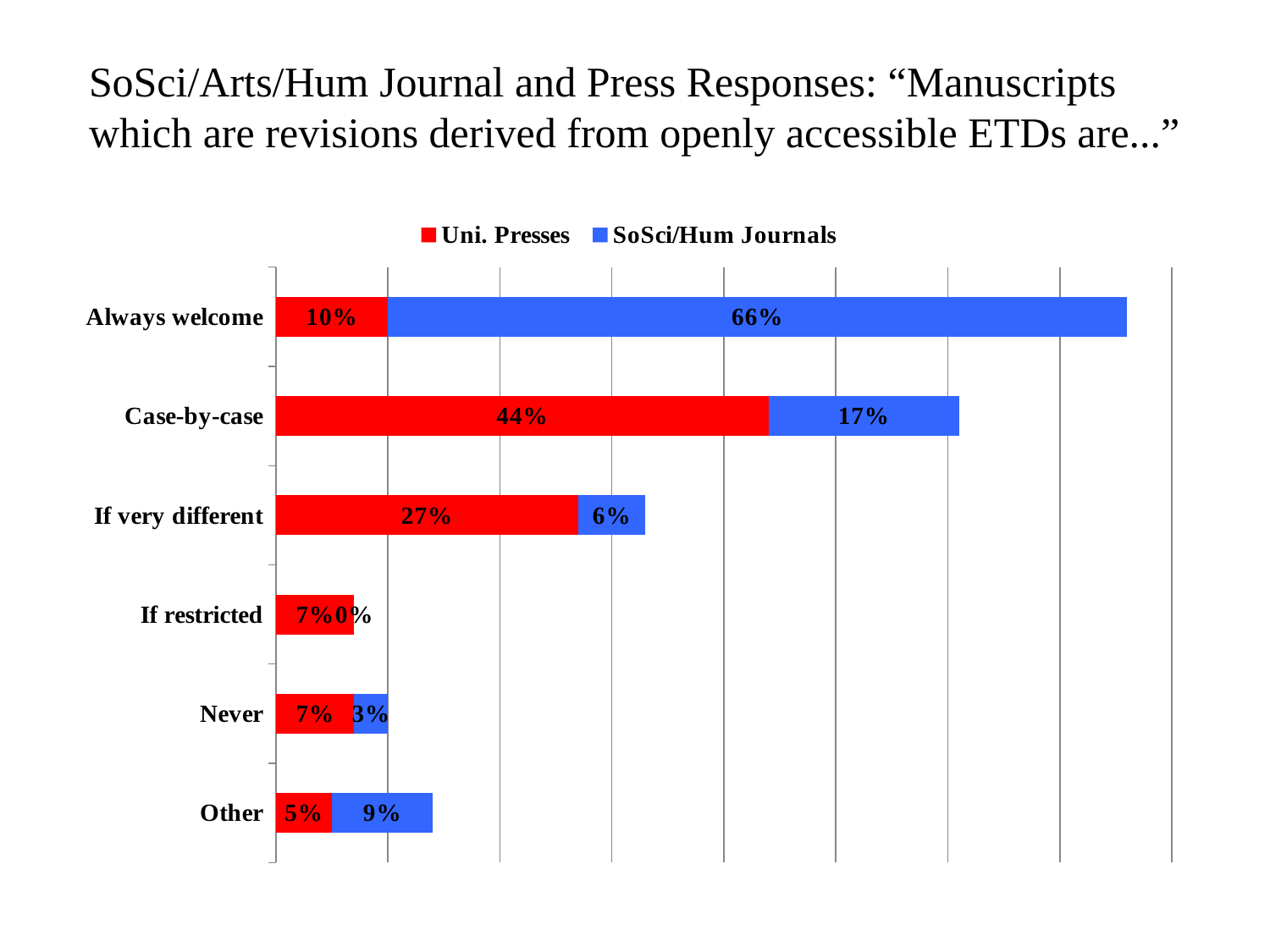
What is the difference between the SoSci/Hum Journals and Uni. Presses values in the "Always welcome" category? 56% Which category has the highest value for Uni. Presses? Case-by-case How many response categories are shown on the chart? 6 What is the value for SoSci/Hum Journals in the "If restricted" category? 0% What is the value for Uni. Presses in the "Case-by-case" category? 44% Which colour represents Uni. Presses in the chart? Red In the "Other" category, which series has the larger value, Uni. Presses or SoSci/Hum Journals? SoSci/Hum Journals What is the value for SoSci/Hum Journals in the "Always welcome" category? 66% What kind of chart is shown on the slide? Stacked bar chart What is the total of the stacked bar for "If very different"? 33% How many series does the legend list? 2 Which category has the lowest value for SoSci/Hum Journals? If restricted